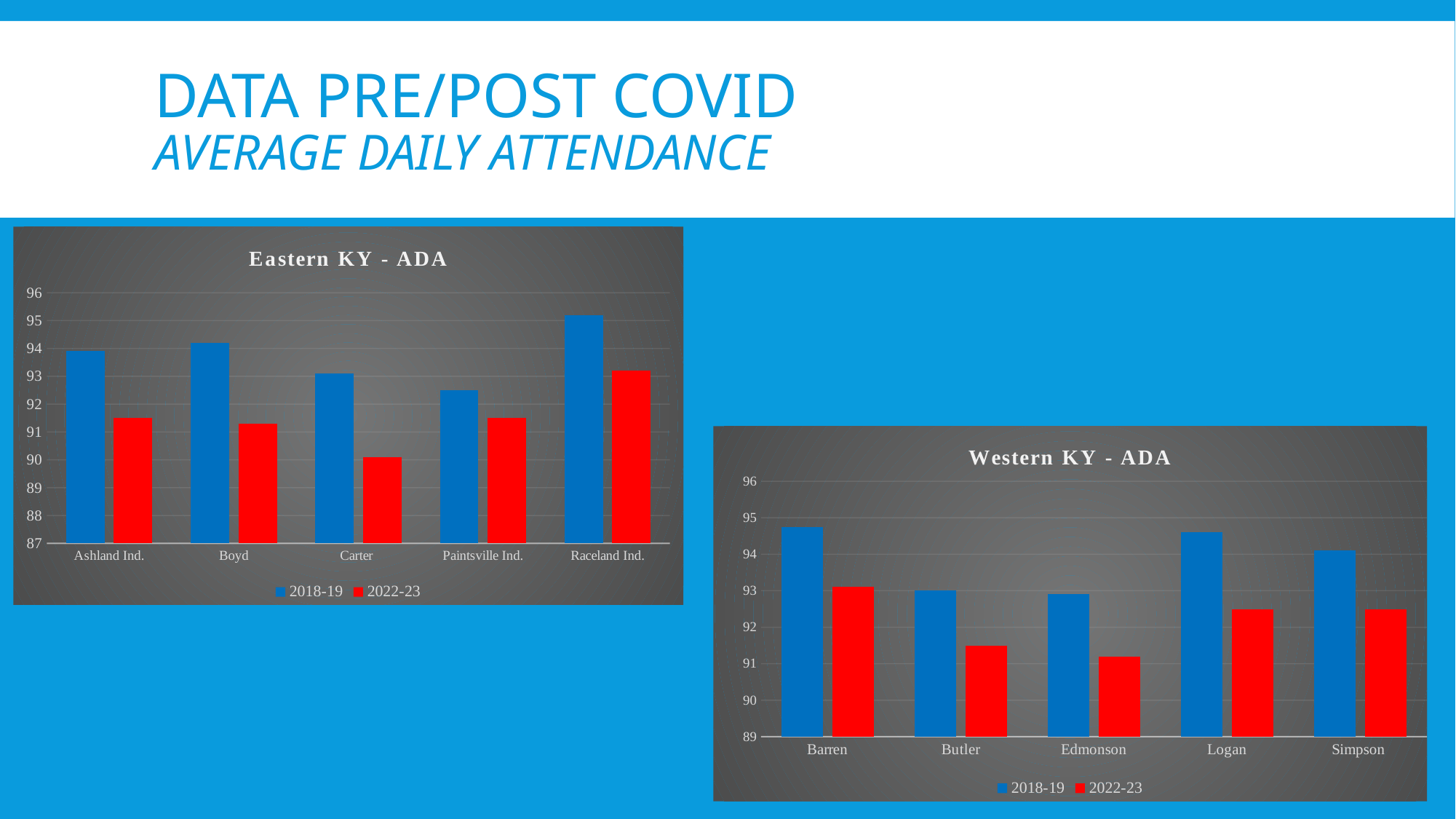
In the Western KY - ADA chart, which colour represents the 2022-23 series? red In the Eastern KY - ADA chart, which is larger: the 2018-19 value for Boyd or the 2018-19 value for Carter? Boyd In the Western KY - ADA chart, which district has the highest 2022-23 value? Barren How many districts are shown on the x axis of the Eastern KY - ADA chart? 5 In the Eastern KY - ADA chart, is the 2022-23 value for Carter greater or less than 91? less In the Western KY - ADA chart, is the 2022-23 value for Butler greater or less than 92? less In the Western KY - ADA chart, is the 2018-19 value for Logan greater or less than 94? greater How many series does the legend of the Western KY - ADA chart list? 2 What type of chart is the Eastern KY - ADA chart? bar chart In the Eastern KY - ADA chart, which district has the highest 2018-19 value? Raceland Ind. In the Eastern KY - ADA chart, which district has the lowest 2022-23 value? Carter